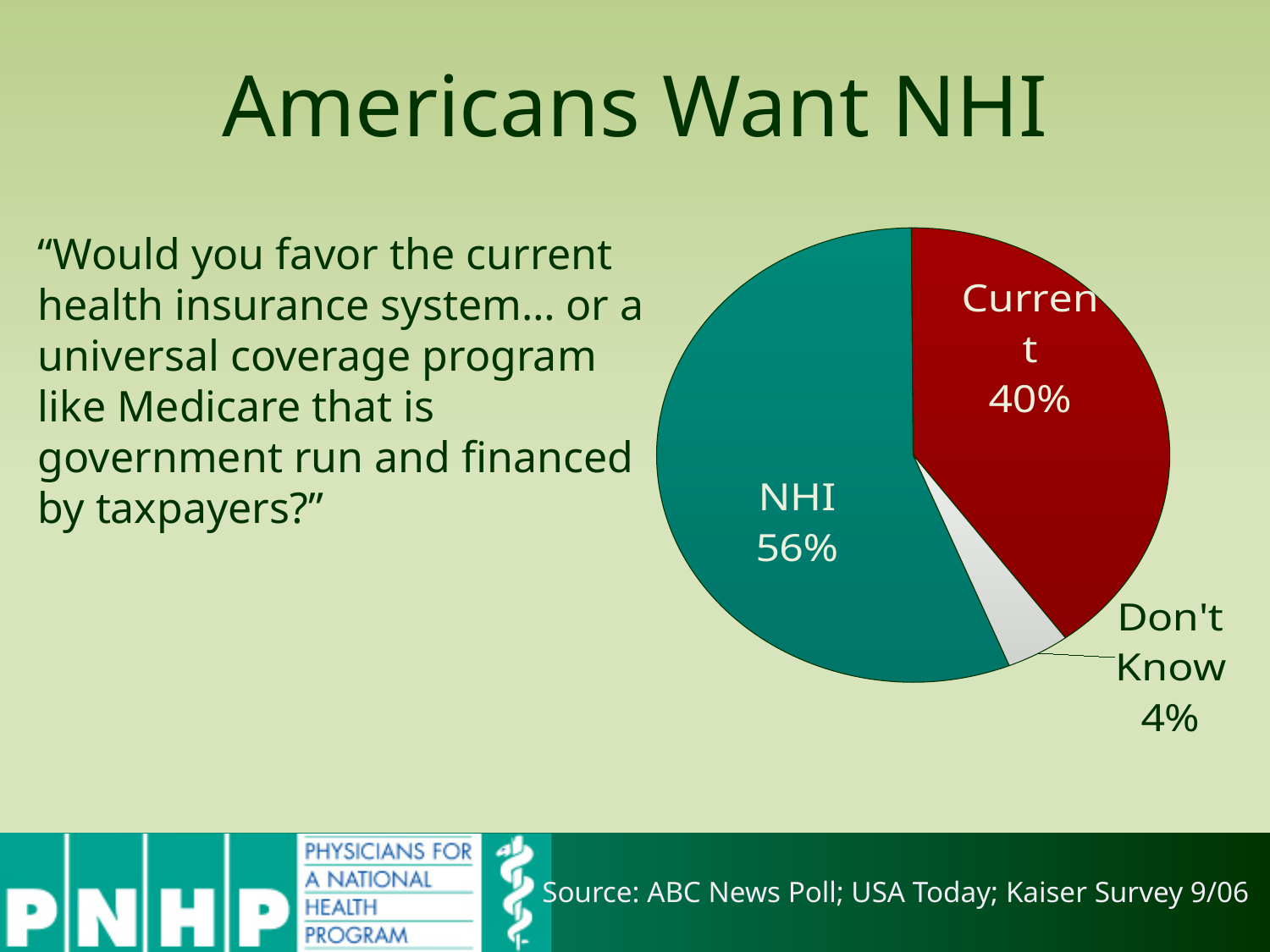
What colour is the NHI slice of the pie chart? Teal What percentage of the pie chart is labelled Don't Know? 4% What percentage of the pie chart is labelled Current? 40% What kind of chart is shown on the slide? Pie chart What is the combined percentage of the NHI and Current slices? 96% Which is larger, the Current slice or the Don't Know slice? Current What percentage of the pie chart is labelled NHI? 56% What is the title of the slide containing the pie chart? Americans Want NHI What is the difference in percentage points between the NHI slice and the Current slice? 16 Which slice of the pie chart is the smallest? Don't Know How many slices does the pie chart have? 3 Which slice of the pie chart is the largest? NHI